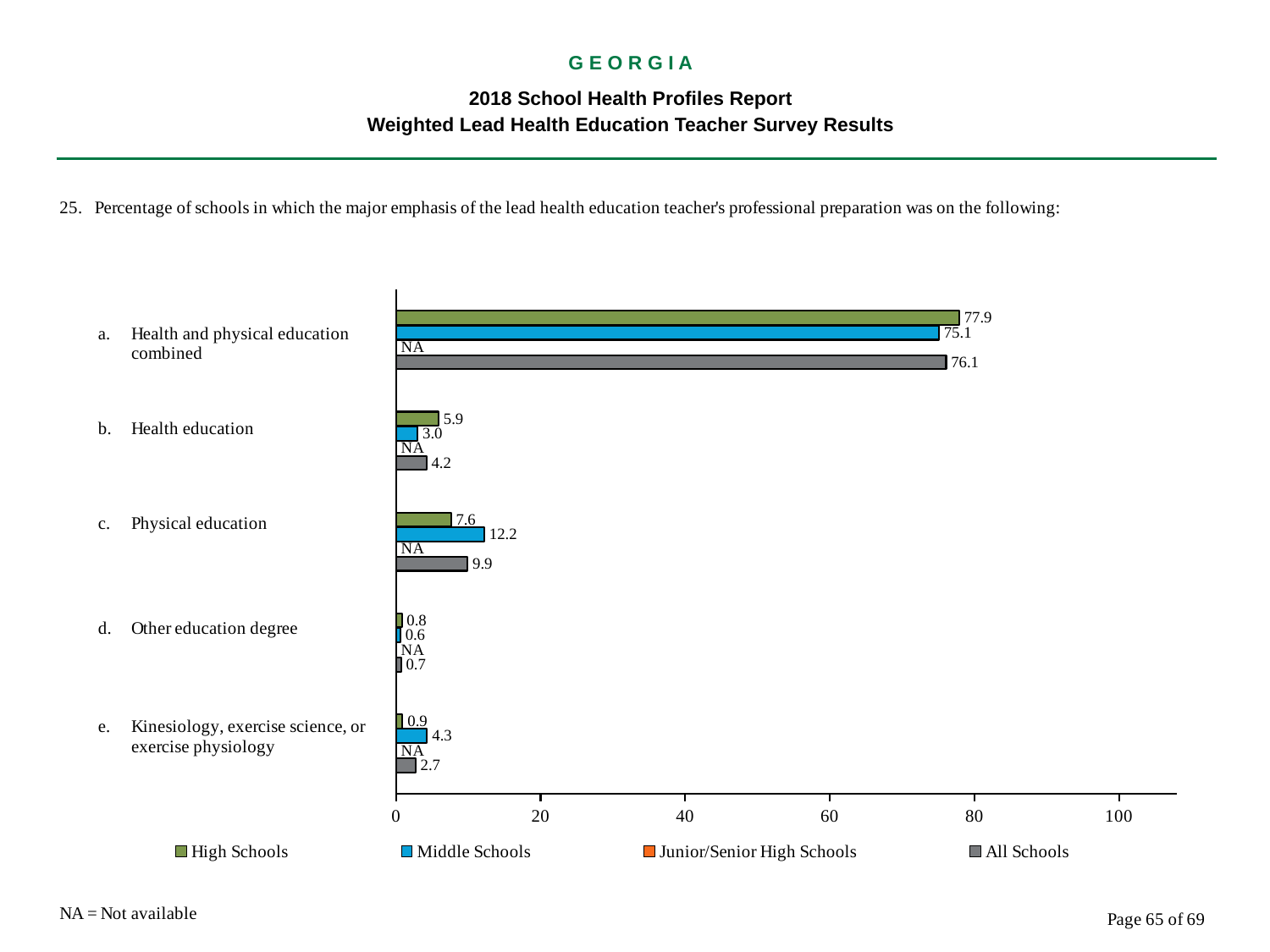
Is the All Schools value for 'Health and physical education combined' greater or less than 60? greater What is the value for Middle Schools for 'Physical education'? 12.2 What is the value for High Schools for 'Health and physical education combined'? 77.9 Which is larger for 'Physical education': the High Schools value or the Middle Schools value? Middle Schools What kind of chart is shown on the slide? bar chart How many series does the legend list? 4 What is the value for Junior/Senior High Schools for 'Health education'? NA What is the value for All Schools for 'Kinesiology, exercise science, or exercise physiology'? 2.7 What is the difference between the High Schools and Middle Schools values for 'Health education'? 2.9 Which category has the highest value for All Schools? Health and physical education combined Which category has the lowest value for Middle Schools? Other education degree How many categories are shown on the chart? 5